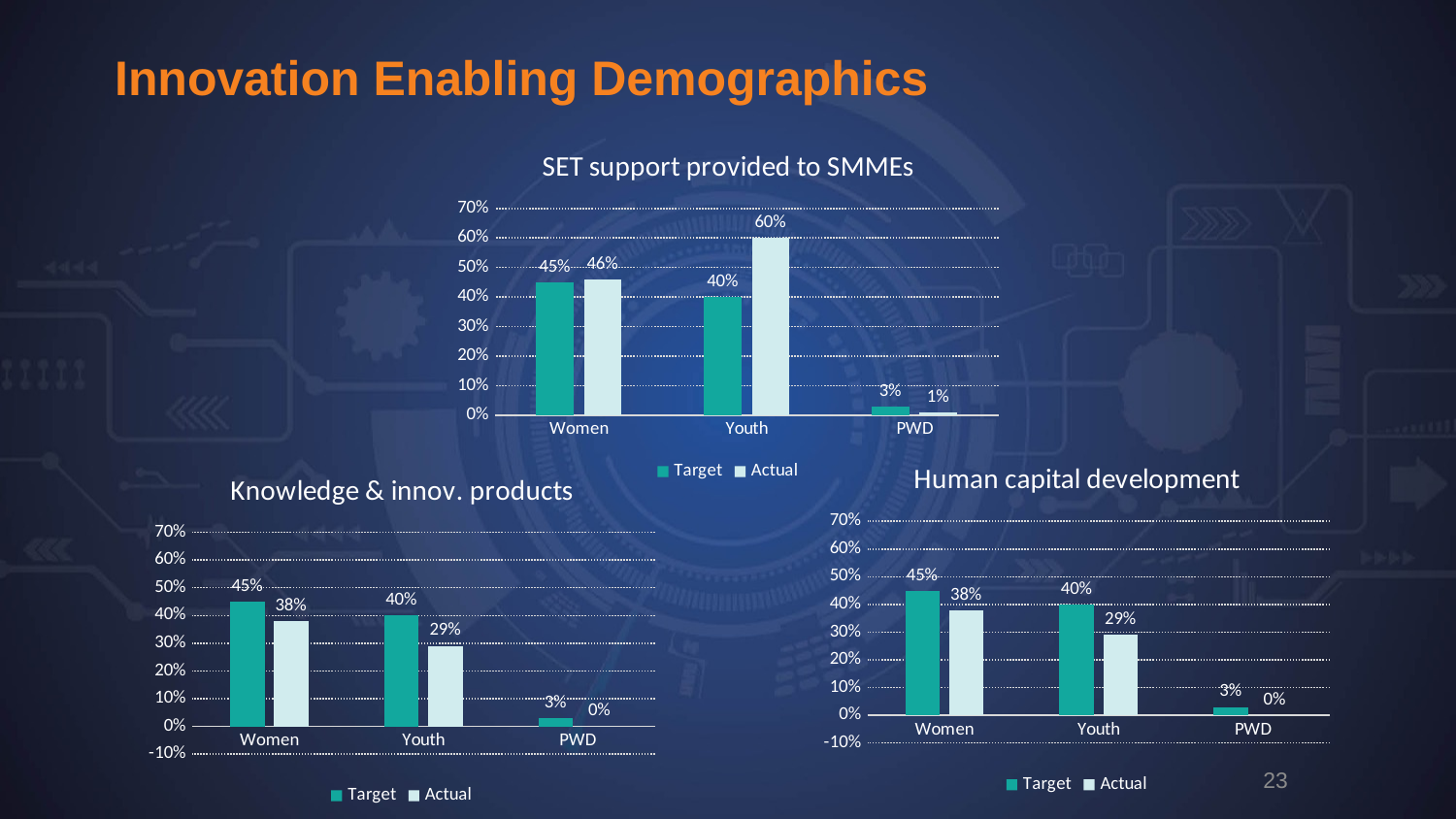
In the 'Human capital development' chart, what is the Target value for Youth? 40% How many series does the legend of the 'SET support provided to SMMEs' chart list? 2 What type of chart is the 'Knowledge & innov. products' chart? Bar chart In the 'SET support provided to SMMEs' chart, which category has the lowest Actual value? PWD In the 'Knowledge & innov. products' chart, what is the Actual value for PWD? 0% In the 'SET support provided to SMMEs' chart, what is the difference between the Actual and Target values for Youth? 20% In the 'SET support provided to SMMEs' chart, what is the Actual value for Youth? 60% In the 'Knowledge & innov. products' chart, what is the Actual value for Youth? 29% In the 'Knowledge & innov. products' chart, which is larger for Women: Target or Actual? Target In the 'Human capital development' chart, which category has the highest Target value? Women In the 'Human capital development' chart, what is the difference between the Target and Actual values for Women? 7% In the 'SET support provided to SMMEs' chart, what is the Target value for Women? 45%